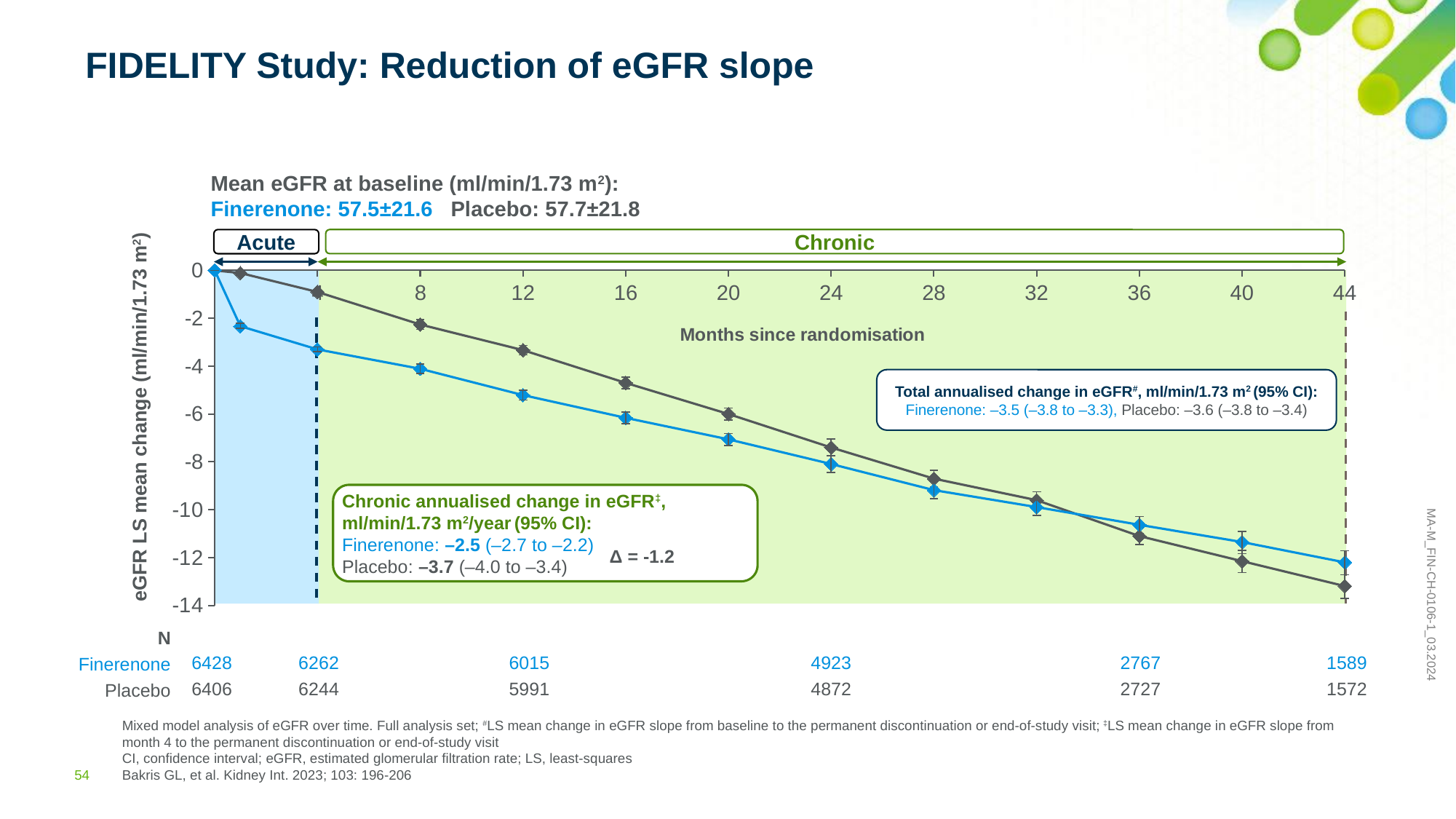
What are the two phases labelled above the chart? Acute and Chronic Is the Placebo value at month 4 greater or less than -2? greater Is the Placebo value at month 24 greater or less than -8? greater What is the chronic annualised change in eGFR for Placebo shown in the chart annotation? –3.7 (–4.0 to –3.4) What kind of chart is shown on the slide? Line chart How many series are plotted in the chart? 2 Is the Finerenone value at month 4 greater or less than -2? less At month 44, which series has the lower eGFR LS mean change, Finerenone or Placebo? Placebo Do the eGFR LS mean change values rise or fall as months since randomisation increase? Fall What is the chronic annualised change in eGFR for Finerenone shown in the chart annotation? –2.5 (–2.7 to –2.2) At month 4, which series has the lower eGFR LS mean change, Finerenone or Placebo? Finerenone